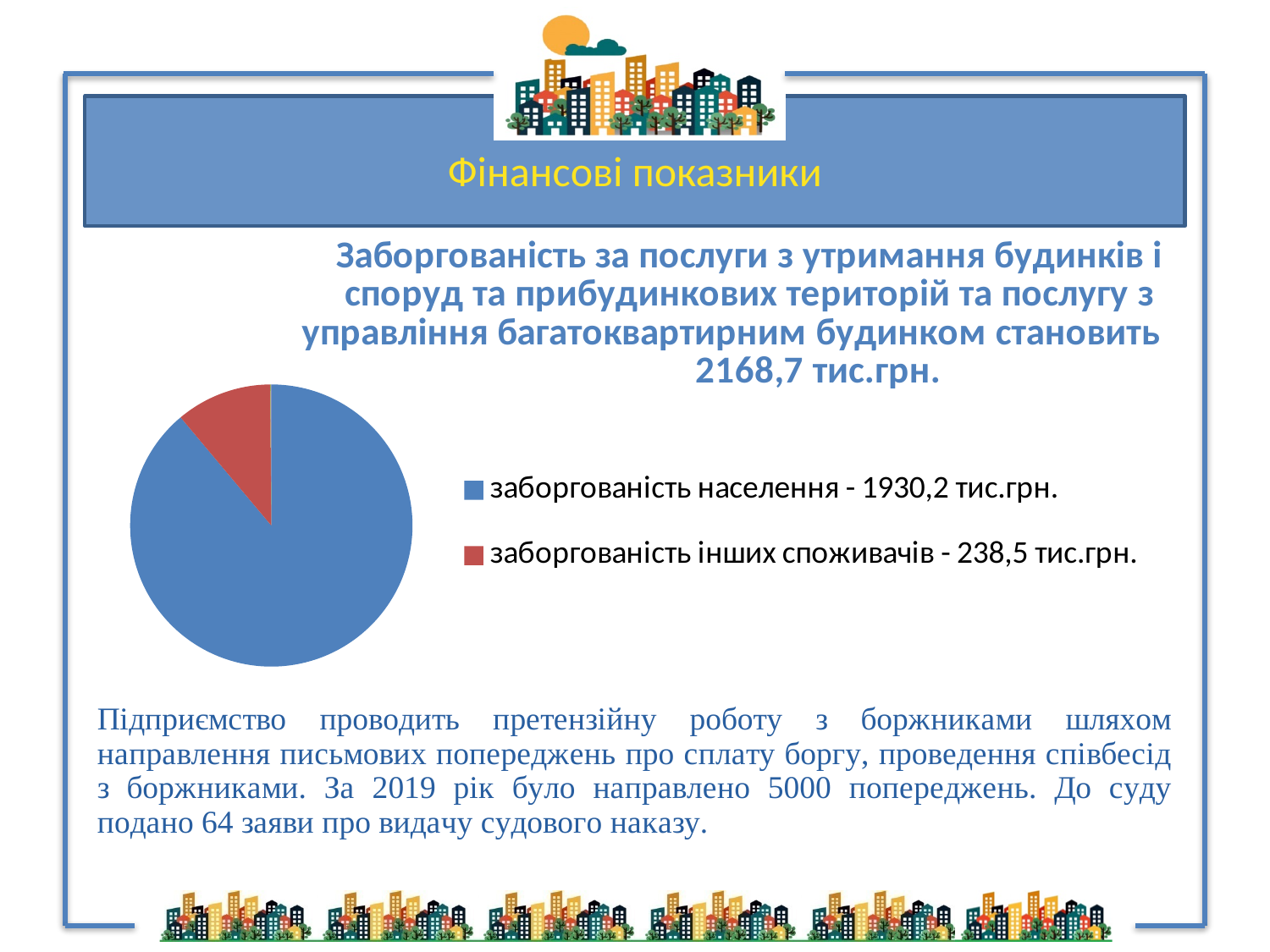
According to the legend, what is the value for "заборгованість інших споживачів"? 238,5 тис.грн. Which is larger: заборгованість населення or заборгованість інших споживачів? заборгованість населення According to the legend, what is the value for "заборгованість населення"? 1930,2 тис.грн. What total debt does the chart title state, in тис.грн.? 2168,7 тис.грн. What kind of chart is shown on the slide? pie chart What colour is the slice for заборгованість населення? blue How many entries does the legend of the pie chart list? 2 Which category has the largest slice of the pie chart? заборгованість населення How many slices does the pie chart have? 2 What is the difference between заборгованість населення and заборгованість інших споживачів, in тис.грн.? 1691,7 тис.грн. Which category has the smallest slice of the pie chart? заборгованість інших споживачів